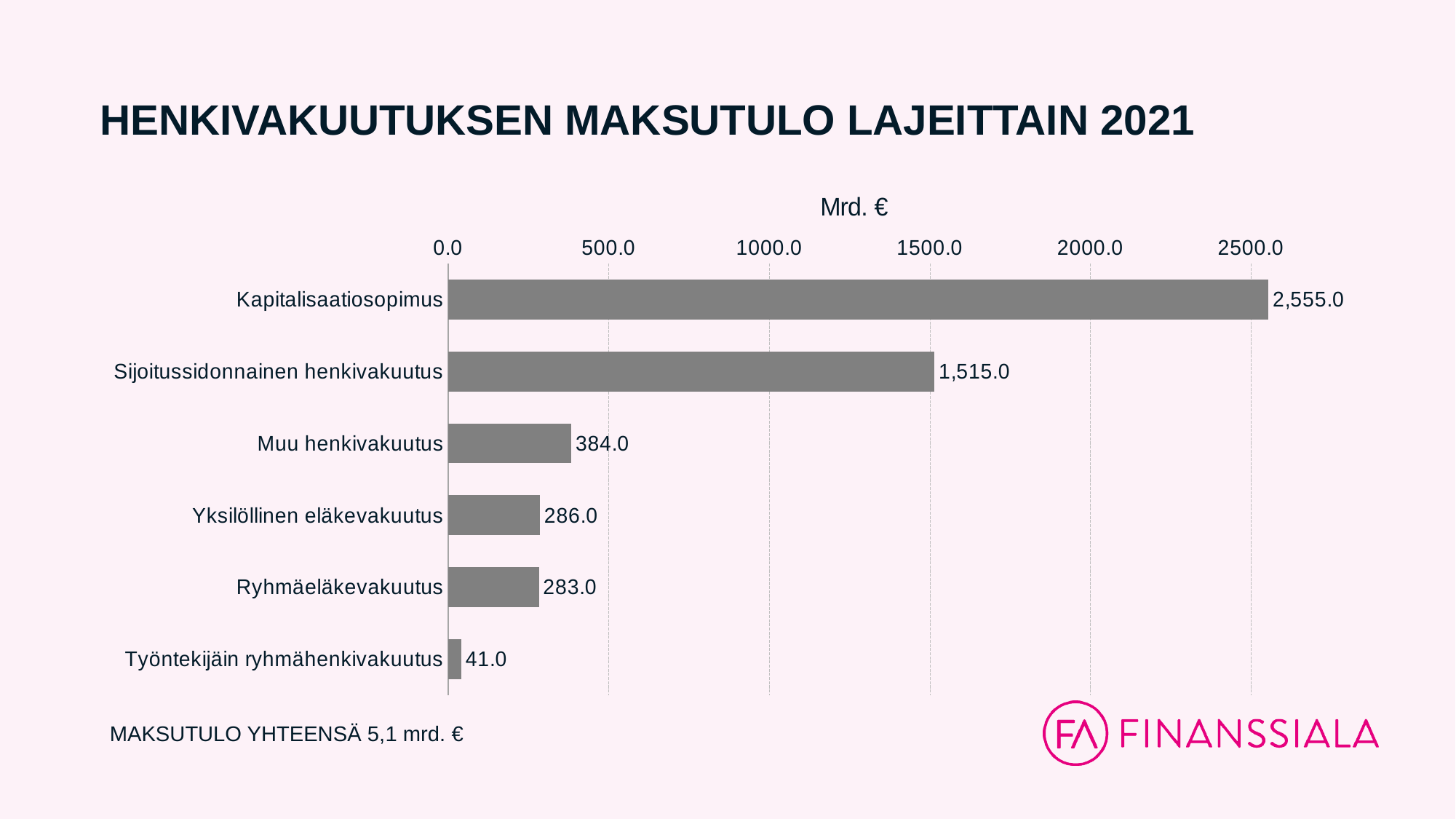
What kind of chart is shown on the slide? Bar chart What is the value for Muu henkivakuutus? 384.0 How many categories are shown in the chart? 6 What is the value for Sijoitussidonnainen henkivakuutus? 1,515.0 Which category has the lowest value? Työntekijäin ryhmähenkivakuutus Is the value for Sijoitussidonnainen henkivakuutus greater or less than 1500.0? greater What is the value for Työntekijäin ryhmähenkivakuutus? 41.0 Which is larger, the value for Muu henkivakuutus or the value for Yksilöllinen eläkevakuutus? Muu henkivakuutus Which category has the highest value? Kapitalisaatiosopimus What is the value for Kapitalisaatiosopimus? 2,555.0 What is the difference between the values for Kapitalisaatiosopimus and Sijoitussidonnainen henkivakuutus? 1,040.0 What is the difference between the values for Yksilöllinen eläkevakuutus and Ryhmäeläkevakuutus? 3.0